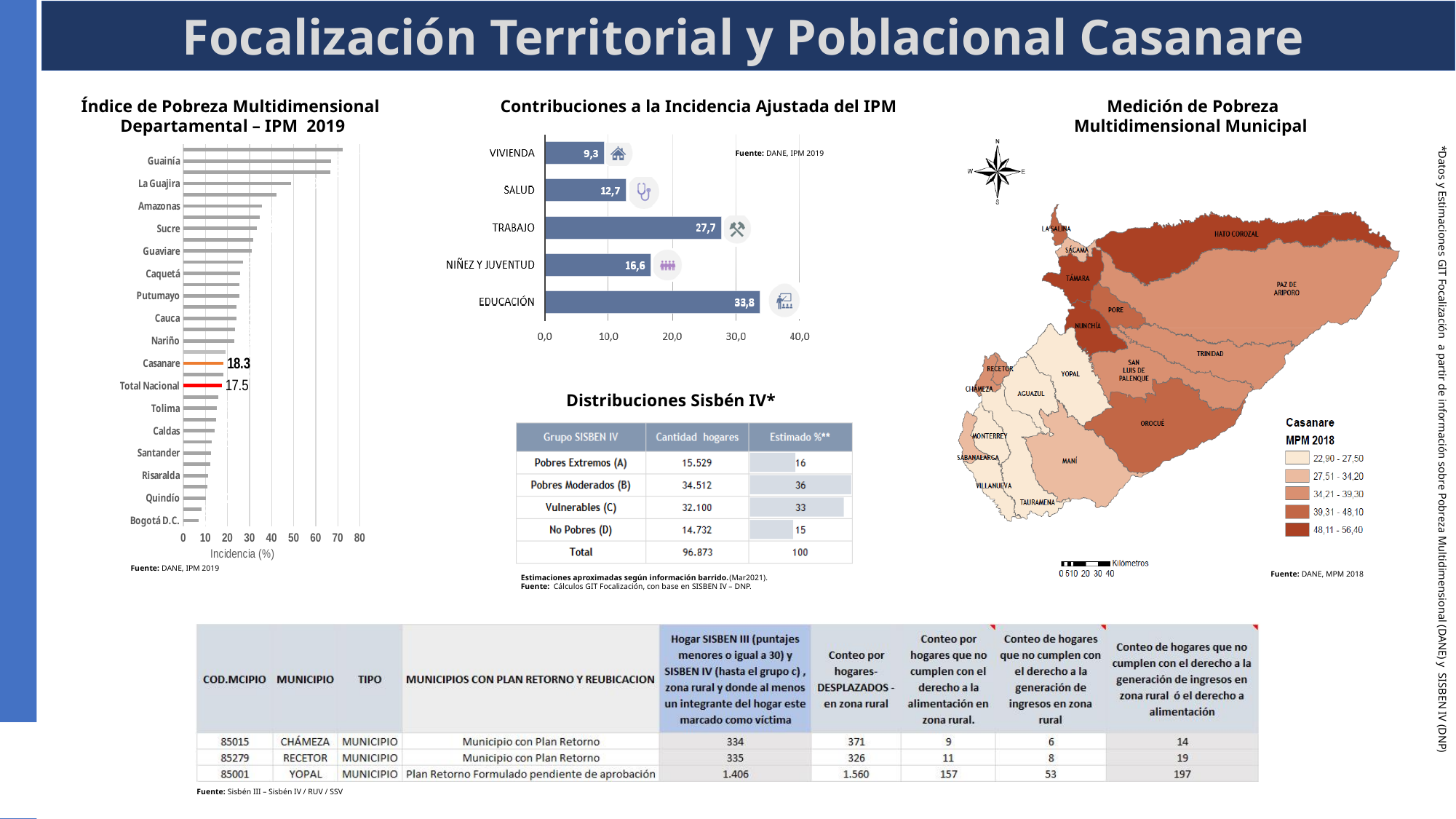
In the chart 'Índice de Pobreza Multidimensional Departamental – IPM 2019', is the value for Guainía greater or less than 60? greater In the chart 'Contribuciones a la Incidencia Ajustada del IPM', which category has the lowest value? VIVIENDA In the chart 'Contribuciones a la Incidencia Ajustada del IPM', what is the value for SALUD? 12,7 In the chart 'Contribuciones a la Incidencia Ajustada del IPM', what is the value for EDUCACIÓN? 33,8 In the chart 'Índice de Pobreza Multidimensional Departamental – IPM 2019', what is the value for Casanare? 18.3 In the chart 'Índice de Pobreza Multidimensional Departamental – IPM 2019', what is the value for Total Nacional? 17.5 What kind of chart is 'Contribuciones a la Incidencia Ajustada del IPM'? Bar chart In the chart 'Contribuciones a la Incidencia Ajustada del IPM', which category has the highest value? EDUCACIÓN In the chart 'Contribuciones a la Incidencia Ajustada del IPM', how many categories are plotted? 5 In the chart 'Índice de Pobreza Multidimensional Departamental – IPM 2019', which is larger, Casanare or Total Nacional? Casanare In the chart 'Contribuciones a la Incidencia Ajustada del IPM', what is the difference between EDUCACIÓN and TRABAJO? 6,1